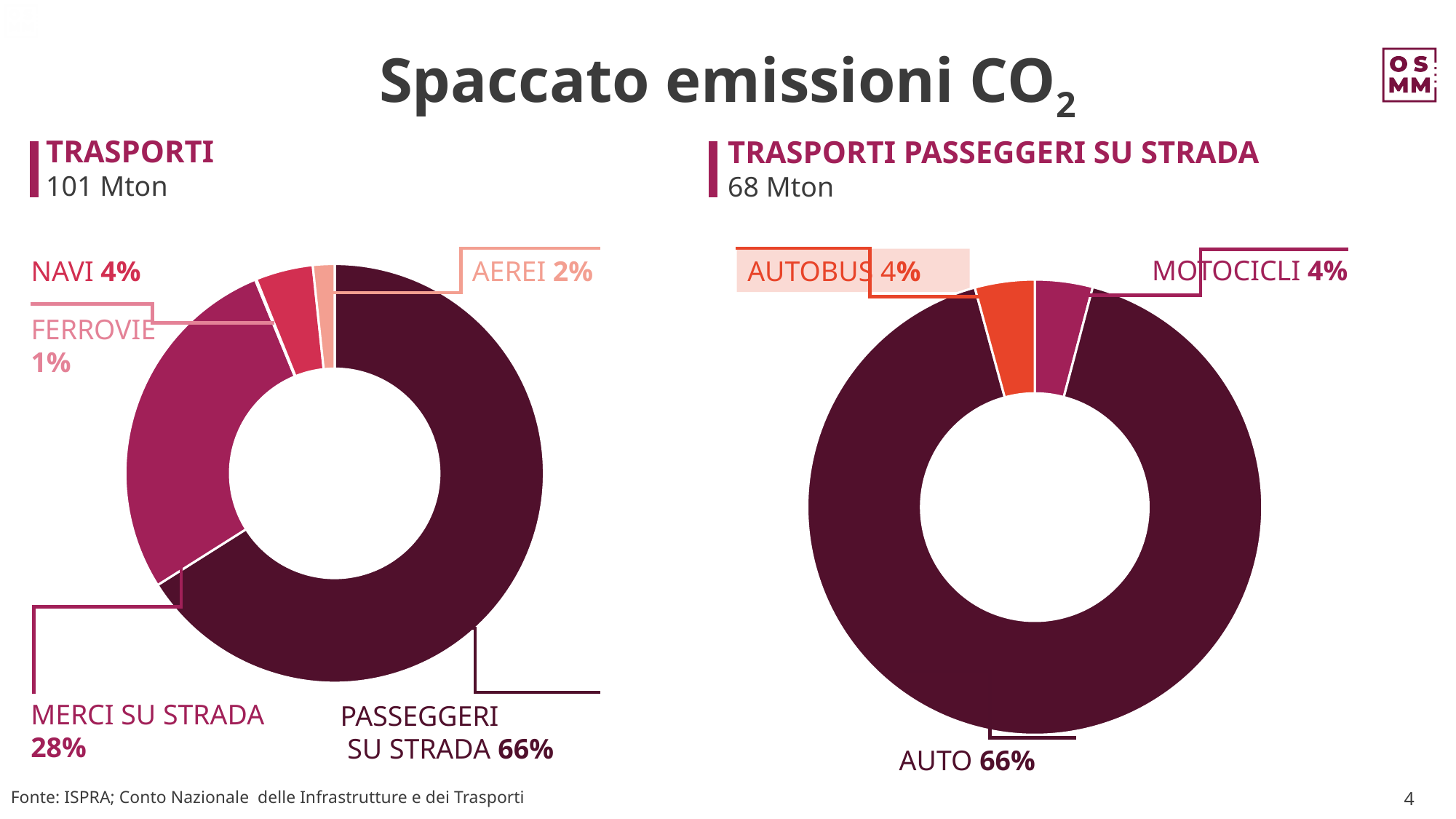
In the TRASPORTI chart, which category has the largest share? PASSEGGERI SU STRADA In the TRASPORTI chart, what share of emissions comes from MERCI SU STRADA? 28% In the TRASPORTI chart, which is larger, the share for NAVI or the share for AEREI? NAVI In the TRASPORTI chart, what is the difference between the shares of PASSEGGERI SU STRADA and MERCI SU STRADA? 38% In the TRASPORTI PASSEGGERI SU STRADA chart, what is the share for MOTOCICLI? 4% What total emissions value is stated for the TRASPORTI PASSEGGERI SU STRADA chart? 68 Mton In the TRASPORTI chart, which category has the smallest share? FERROVIE In the TRASPORTI chart, what is the share for NAVI? 4% How many categories are shown in the TRASPORTI PASSEGGERI SU STRADA chart? 3 In the TRASPORTI chart, what share of emissions comes from PASSEGGERI SU STRADA? 66% How many categories are shown in the TRASPORTI chart? 5 In the TRASPORTI PASSEGGERI SU STRADA chart, what is the share for AUTO? 66%